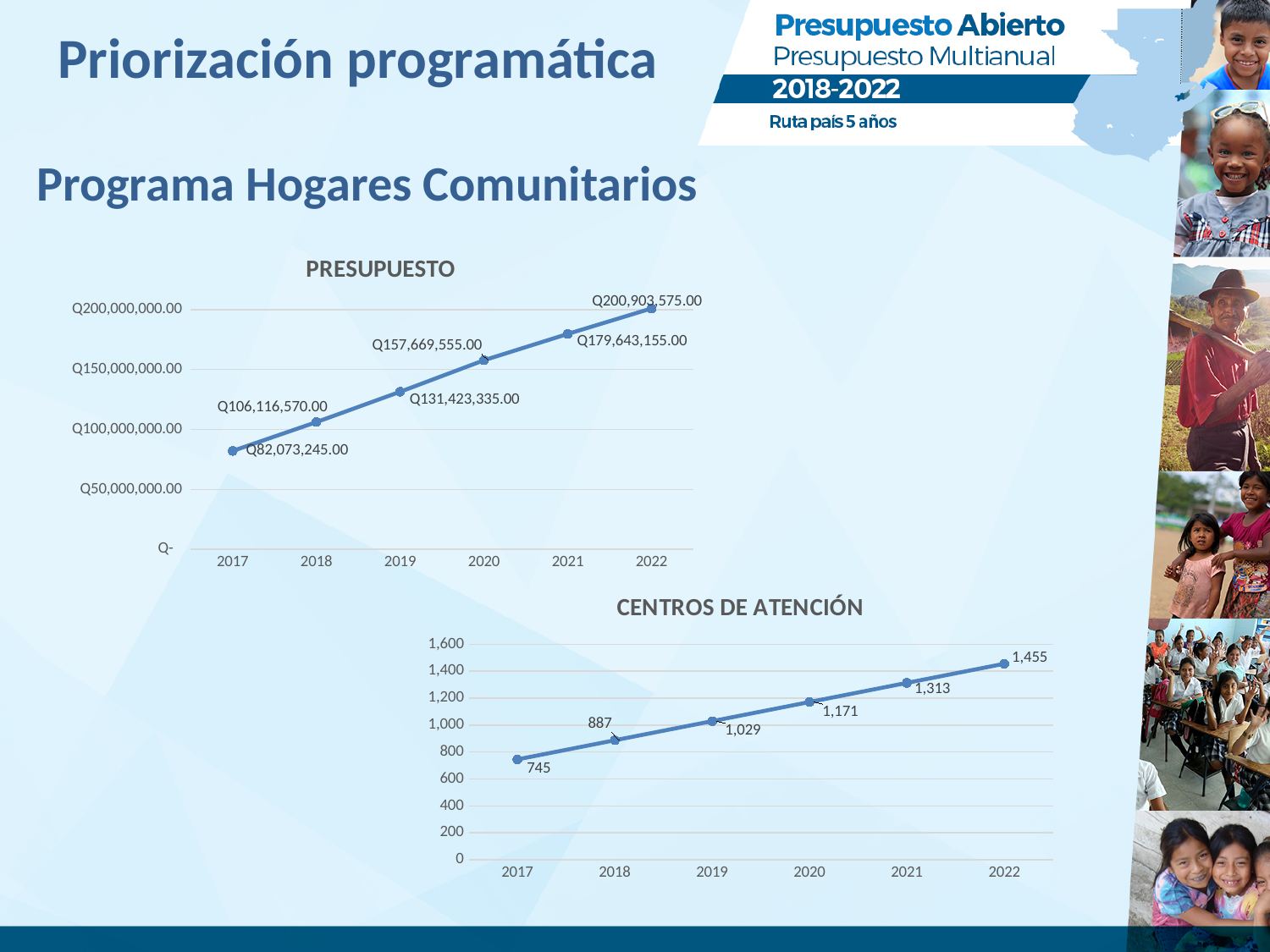
In the CENTROS DE ATENCIÓN chart, which year has the lowest value? 2017 In the PRESUPUESTO chart, which year has the highest value? 2022 In the PRESUPUESTO chart, what is the value for 2020? Q157,669,555.00 In the CENTROS DE ATENCIÓN chart, what is the value for 2019? 1,029 In the PRESUPUESTO chart, what is the value for 2017? Q82,073,245.00 In the CENTROS DE ATENCIÓN chart, what is the value for 2022? 1,455 In the PRESUPUESTO chart, do the values rise or fall from 2017 to 2022? rise In the CENTROS DE ATENCIÓN chart, what is the difference between the 2018 and 2017 values? 142 What kind of chart is the CENTROS DE ATENCIÓN chart? line chart In the PRESUPUESTO chart, what is the difference between the 2022 and 2017 values? Q118,830,330.00 In the PRESUPUESTO chart, how many years are plotted? 6 In the CENTROS DE ATENCIÓN chart, is the value for 2021 greater or less than 1,200? greater